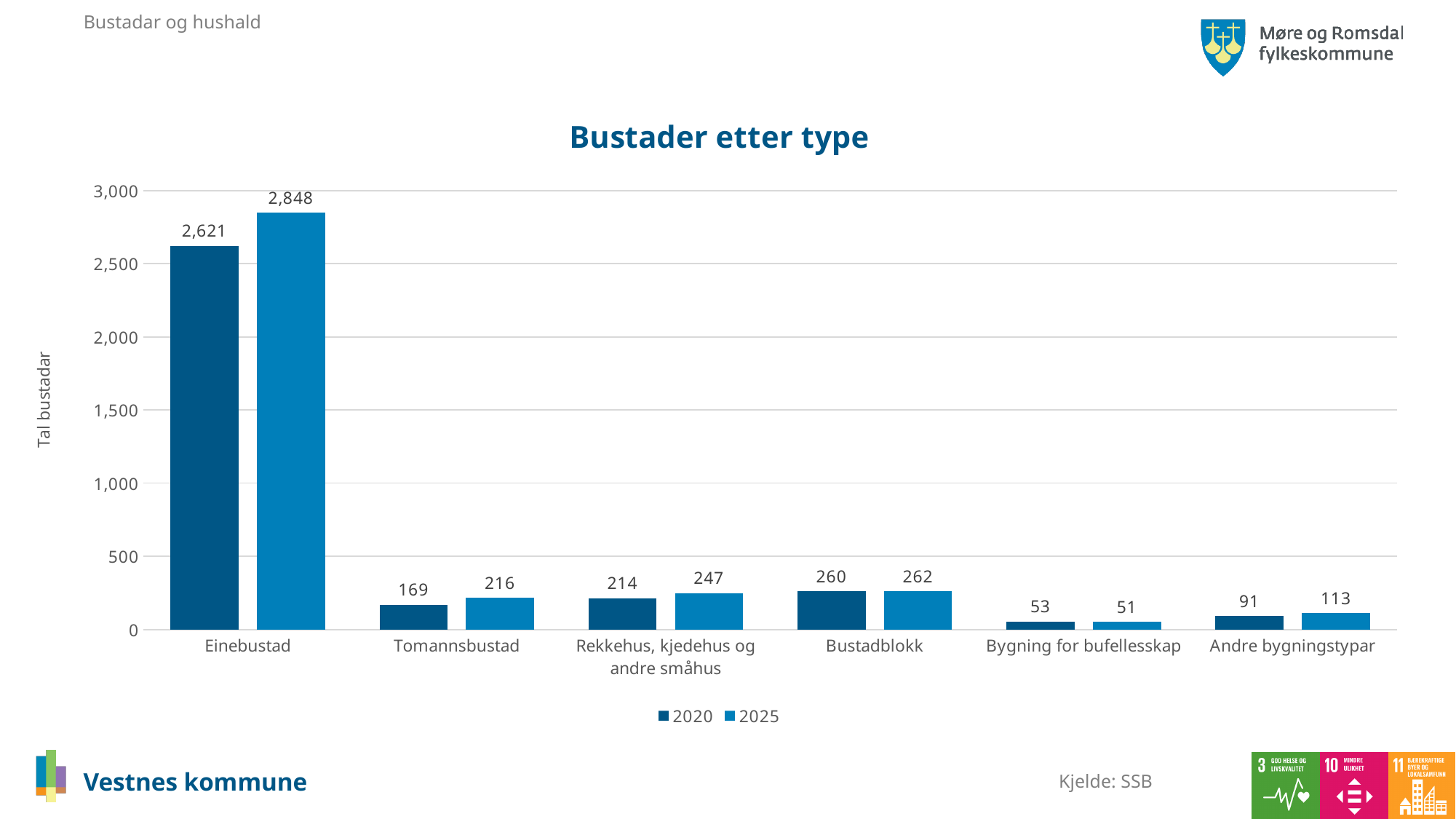
What is the difference between the 2025 and 2020 values for Andre bygningstypar? 22 What is the value for Einebustad in 2025? 2,848 Which is larger for Rekkehus, kjedehus og andre småhus: the 2020 value or the 2025 value? 2025 How many categories are shown on the x axis? 6 What is the value for Tomannsbustad in 2020? 169 What is the title of the chart? Bustader etter type Which category has the highest value in 2020? Einebustad What is the difference between the 2025 and 2020 values for Einebustad? 227 Which category has the lowest value in 2025? Bygning for bufellesskap What is the value for Bygning for bufellesskap in 2025? 51 How many series does the legend list? 2 What kind of chart is shown? bar chart